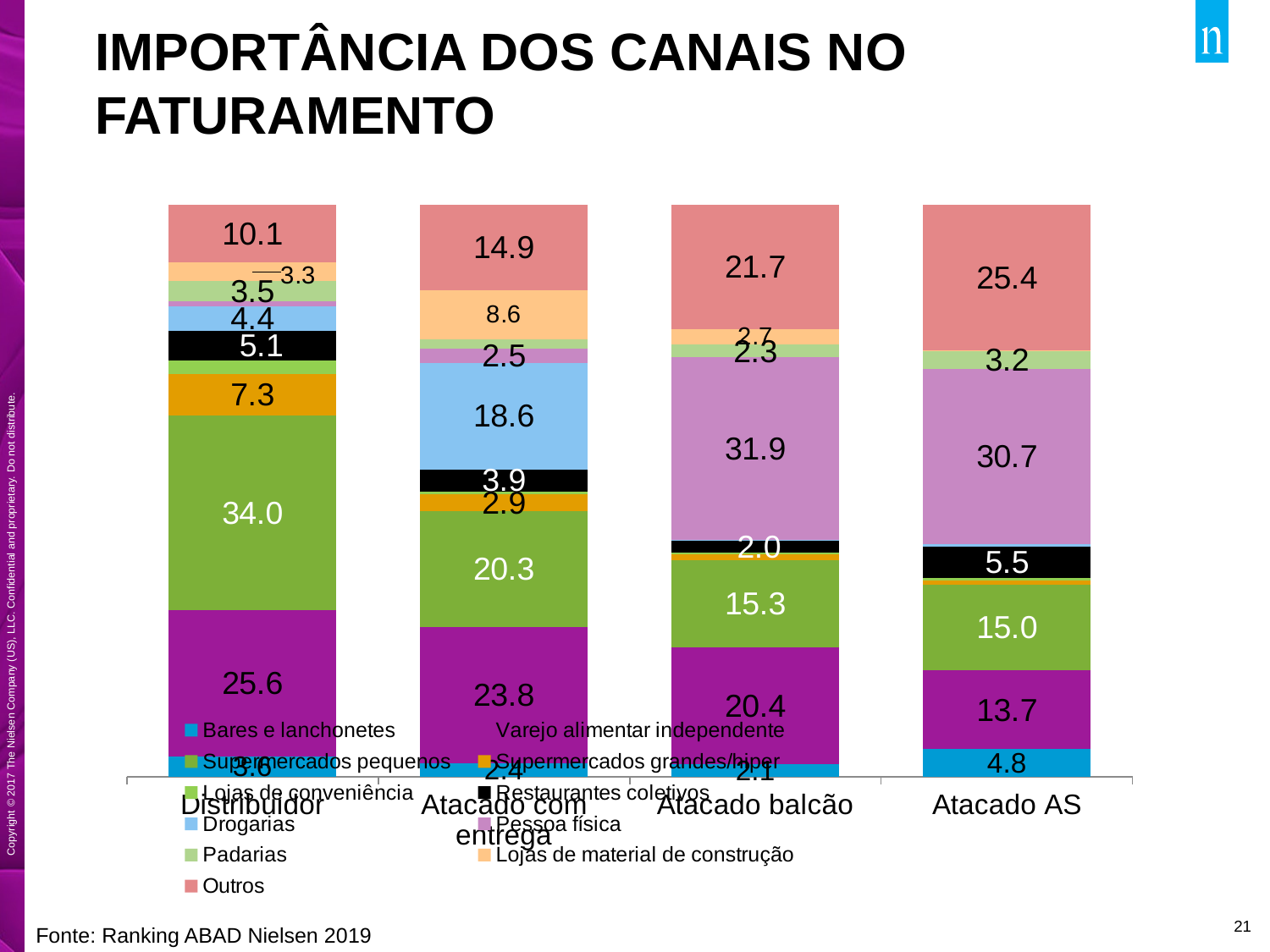
Which is larger: Supermercados pequenos for Distribuidor or for Atacado com entrega? Distribuidor How many series does the legend list? 11 What type of chart is shown on the slide? Stacked bar chart What is the value of Pessoa física for Atacado balcão? 31.9 Which category has the lowest value for Bares e lanchonetes? Atacado balcão Which category has the highest value for Outros? Atacado AS What is the value of Outros for Atacado AS? 25.4 What is the value of Varejo alimentar independente for Atacado com entrega? 23.8 What is the value of Drogarias for Atacado com entrega? 18.6 What is the value of Supermercados pequenos for Distribuidor? 34.0 What is the difference between the Pessoa física values for Atacado balcão and Atacado AS? 1.2 How many channel categories are shown along the x axis? 4